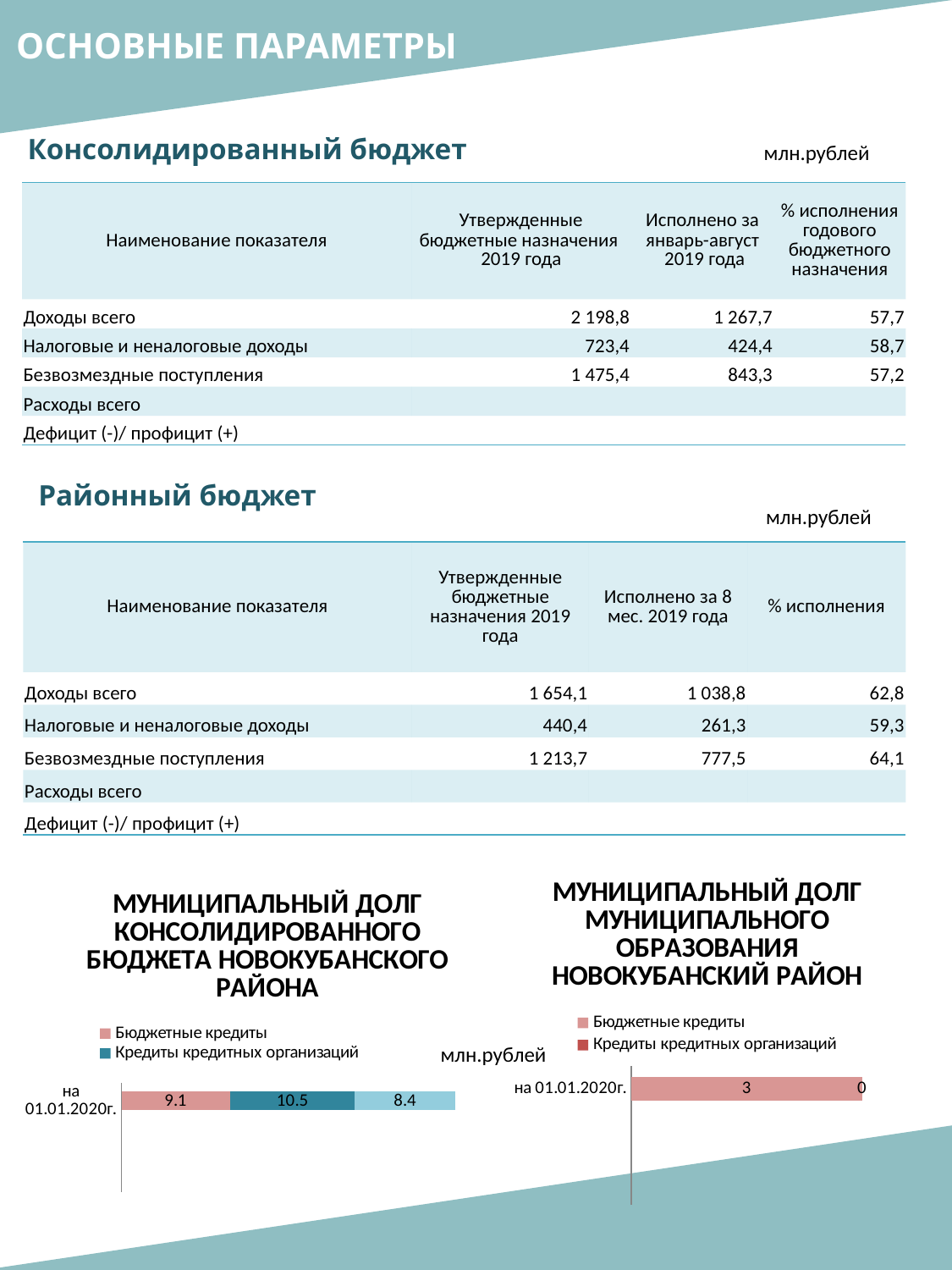
On the left chart (consolidated budget municipal debt), how many dates (categories) are plotted? 1 On the left chart (consolidated budget municipal debt), what is the value for 'Бюджетные кредиты' as of 01.01.2020? 9.1 On the right chart (municipal formation debt), what is the value for 'Кредиты кредитных организаций'? 0 On the left chart (consolidated budget municipal debt), what is the value for 'Кредиты кредитных организаций' as of 01.01.2020? 10.5 On the right chart (municipal formation debt), what date label is shown for the plotted bar? на 01.01.2020г. On the left chart titled 'МУНИЦИПАЛЬНЫЙ ДОЛГ КОНСОЛИДИРОВАННОГО БЮДЖЕТА НОВОКУБАНСКОГО РАЙОНА', what kind of chart is shown? bar chart On the left chart (consolidated budget municipal debt), how many entries does the legend list? 2 On the left chart (consolidated budget municipal debt), how much larger is 'Кредиты кредитных организаций' than 'Бюджетные кредиты'? 1.4 On the left chart (consolidated budget municipal debt), what is the largest value labelled on the bar? 10.5 On the right chart titled 'МУНИЦИПАЛЬНЫЙ ДОЛГ МУНИЦИПАЛЬНОГО ОБРАЗОВАНИЯ НОВОКУБАНСКИЙ РАЙОН', what is the value for 'Бюджетные кредиты'? 3 On the right chart (municipal formation debt), which is larger: 'Бюджетные кредиты' or 'Кредиты кредитных организаций'? Бюджетные кредиты On the left chart (consolidated budget municipal debt), what is the total of all segments of the stacked bar for 01.01.2020? 28